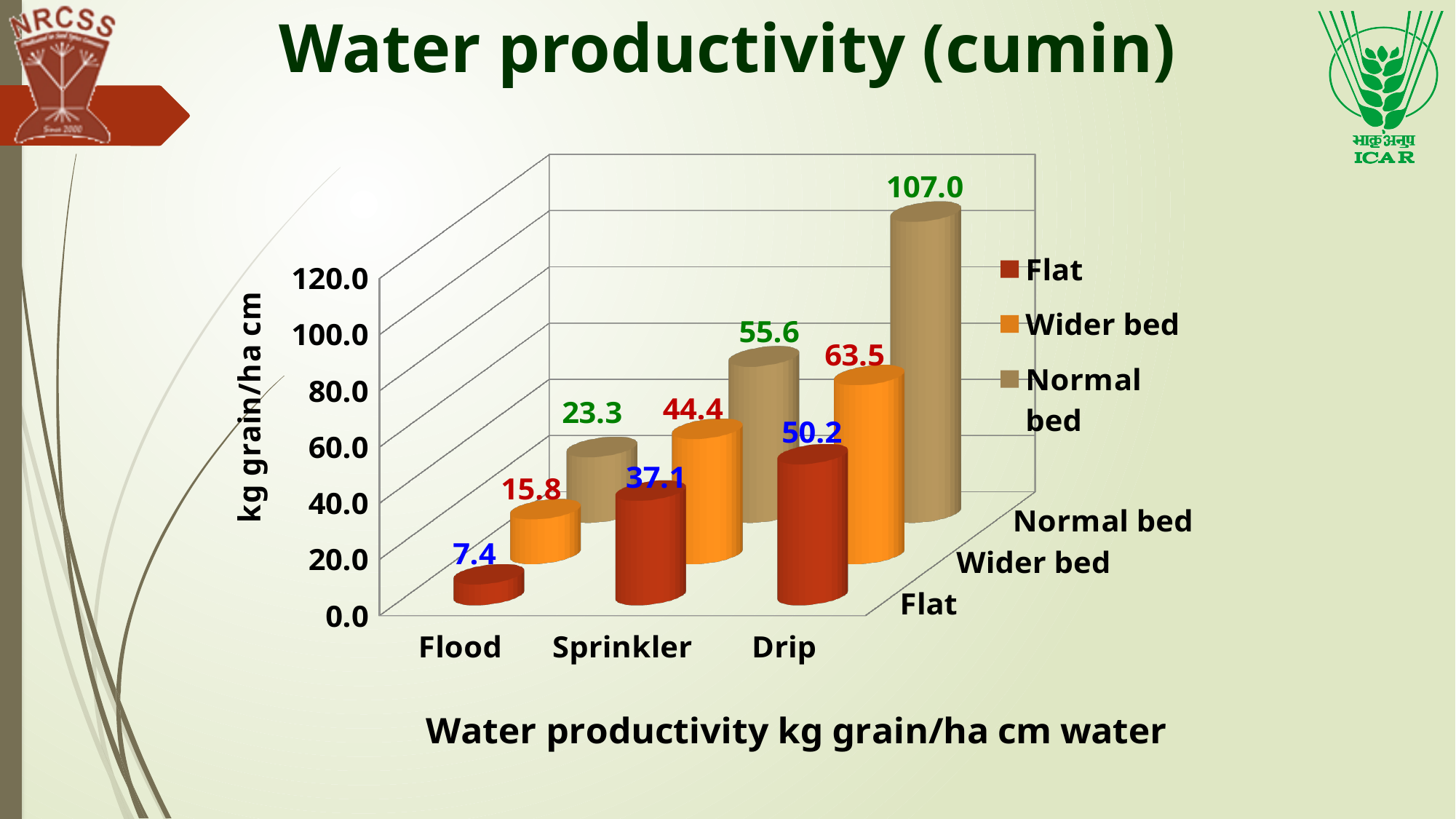
Do the Flat series values rise or fall from Flood to Drip? Rise Which is larger: the Flat value for Drip or the Wider bed value for Sprinkler? Flat value for Drip Which irrigation method has the lowest water productivity for the Wider bed series? Flood What kind of chart is shown on the slide? Bar chart Which irrigation method has the highest water productivity for the Normal bed series? Drip What is the water productivity for Drip irrigation on a Normal bed? 107.0 What is the water productivity for Flood irrigation on a Flat bed? 7.4 How many irrigation methods are shown on the x axis? 3 How many series does the legend list? 3 What is the water productivity for Sprinkler irrigation on a Wider bed? 44.4 What is the difference in water productivity between Wider bed and Flat for Drip irrigation? 13.3 What is the difference in water productivity between Drip and Sprinkler irrigation on a Normal bed? 51.4